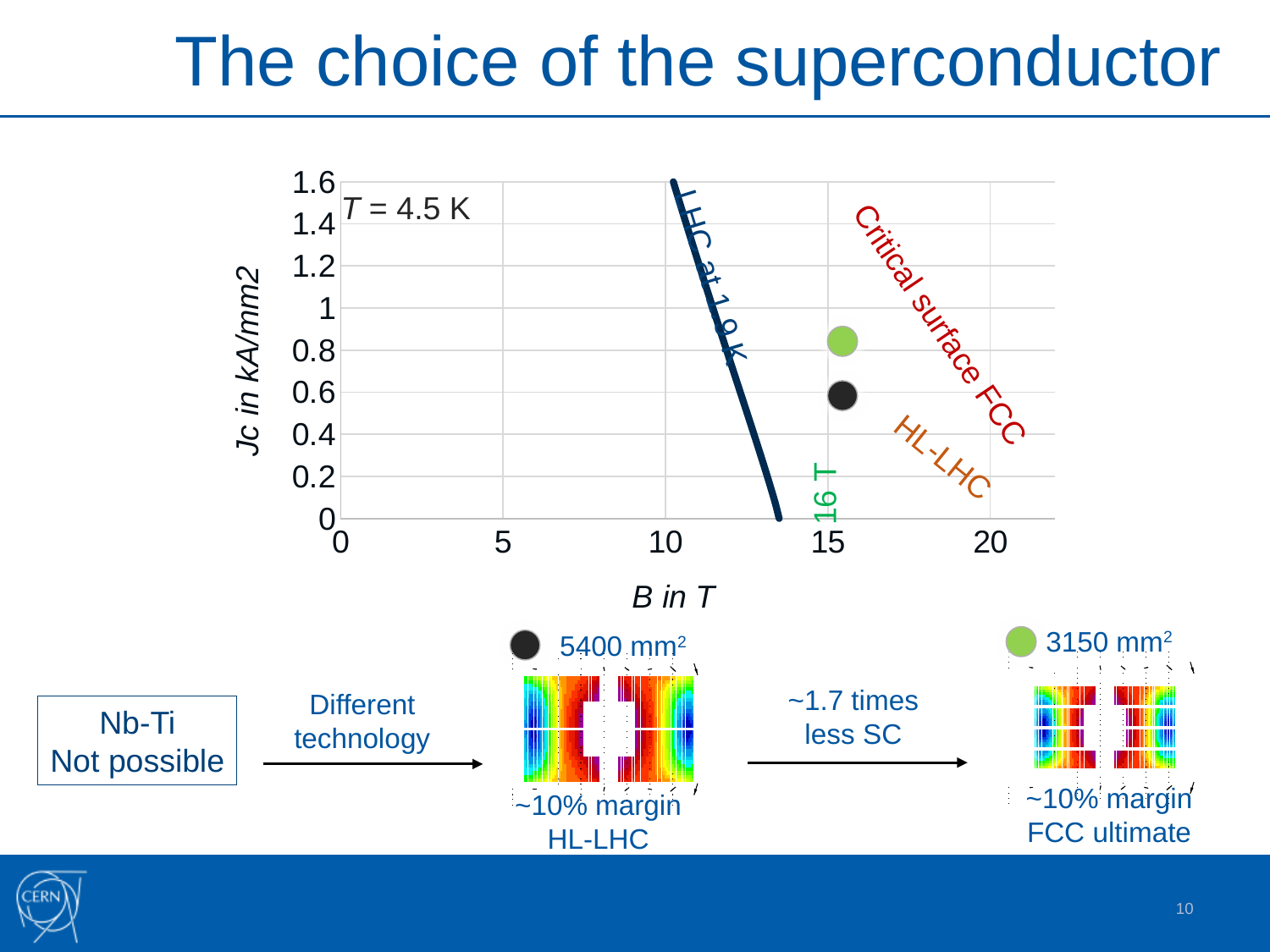
What is the label of the y axis of the chart? Jc in kA/mm2 Does the 'LHC at 1.9 K' line rise or fall as B increases? fall Is the B value where the 'LHC at 1.9 K' line reaches Jc = 0 greater or less than 15? less Is the Jc value of the green (FCC) point greater or less than 1? less How many circular data points are plotted on the chart? 2 Is the Jc value of the black (HL-LHC) point greater or less than 0.8? less Which point has the higher Jc value, the green (FCC) point or the black (HL-LHC) point? the green (FCC) point What is the label of the x axis of the chart? B in T